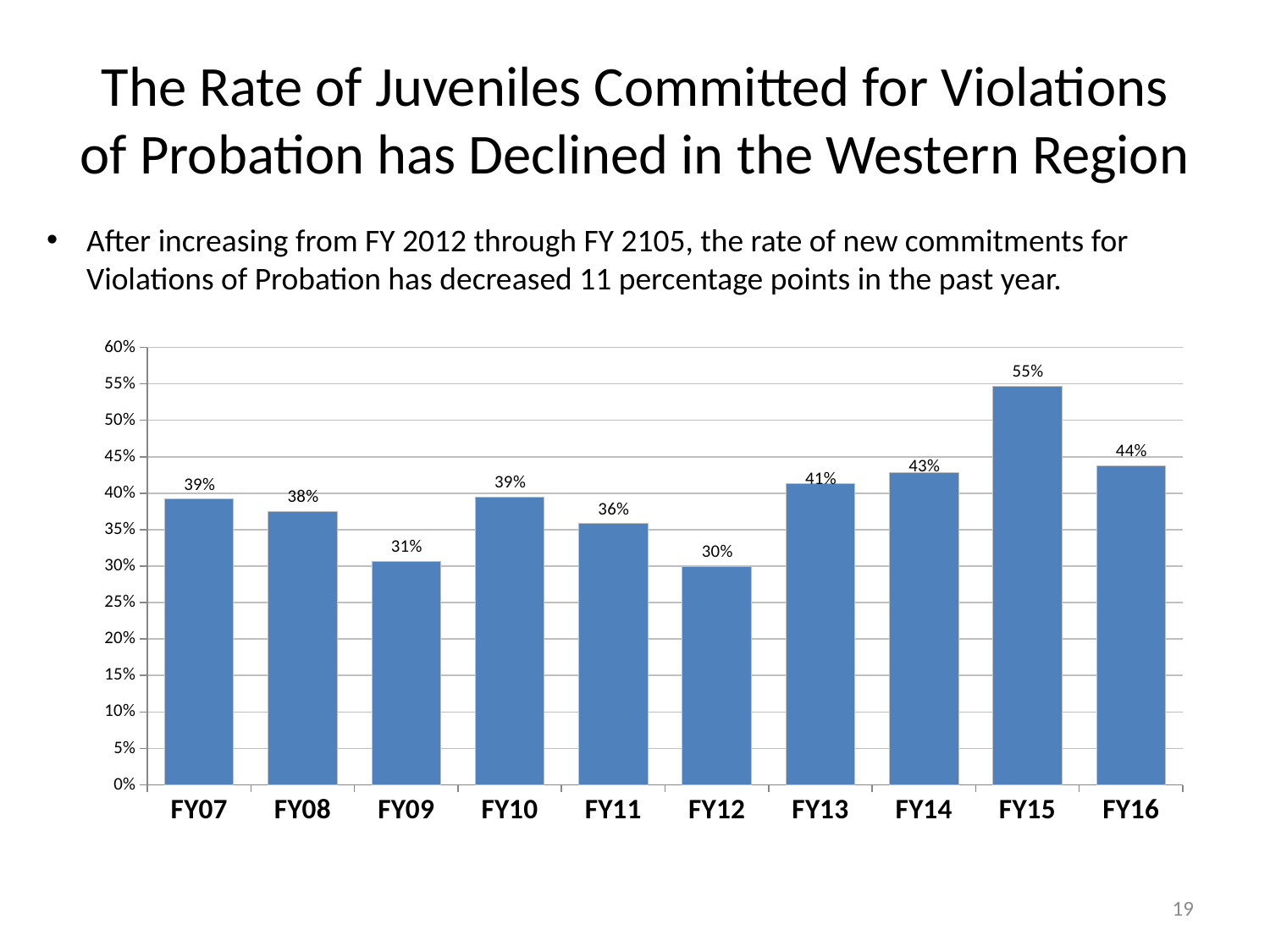
Which fiscal year has the highest value? FY15 What is the difference between the values for FY15 and FY16? 11 percentage points Is the value for FY14 greater or less than 40%? greater What is the value for FY15? 55% What is the value for FY16? 44% What kind of chart is shown on the slide? bar chart How many fiscal years are shown on the x axis? 10 What is the difference between the values for FY13 and FY12? 11 percentage points What is the value for FY12? 30% Which fiscal year has the lowest value? FY12 Do the values rise or fall from FY12 to FY15? rise Which is larger, the value for FY09 or the value for FY11? FY11